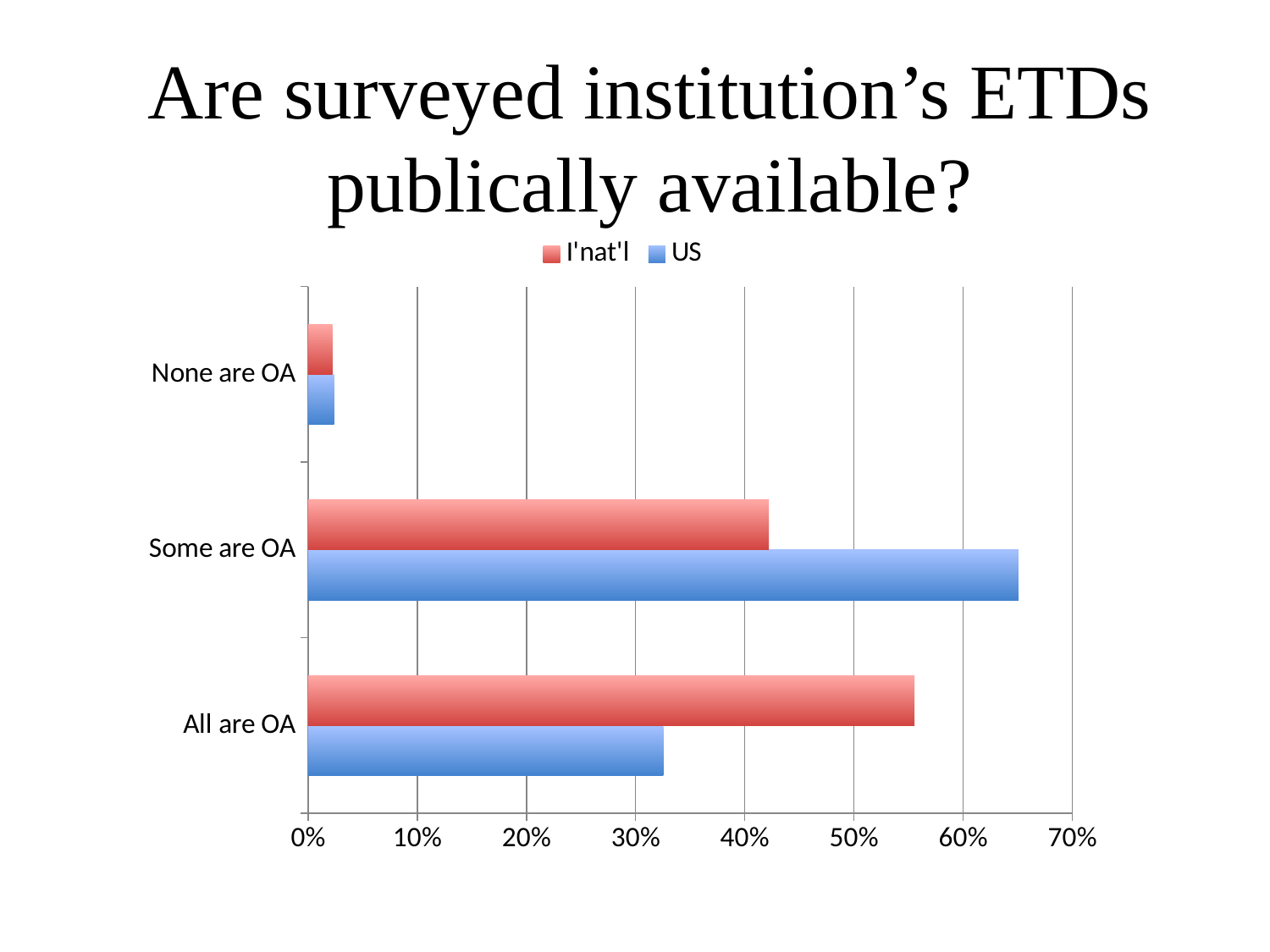
How many series does the legend list? 2 Which colour represents the US series in the legend? blue How many categories are shown on the chart? 3 Which category has the highest value for the US series? Some are OA Which category has the lowest value for the US series? None are OA Which category has the highest value for the I'nat'l series? All are OA For 'Some are OA', which series has the larger value, I'nat'l or US? US What kind of chart is shown on the slide? bar chart Is the US value for 'Some are OA' greater or less than 60%? greater Is the I'nat'l value for 'All are OA' greater or less than 50%? greater Which category has the lowest value for the I'nat'l series? None are OA For 'All are OA', which series has the larger value, I'nat'l or US? I'nat'l